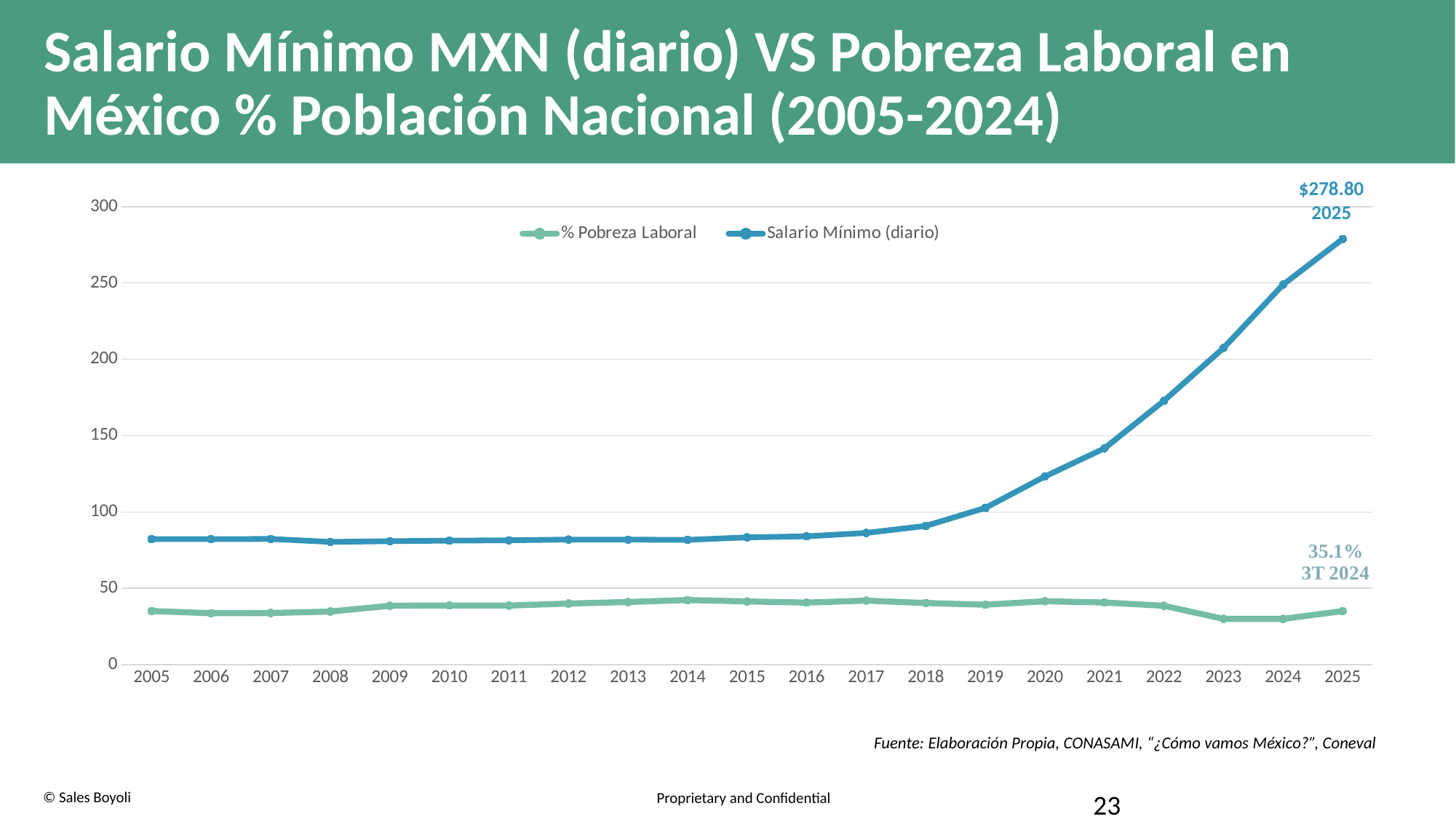
What is the value of Salario Mínimo (diario) for 2025? $278.80 Is the value of Salario Mínimo (diario) for 2021 greater or less than 150? less Is the value of Salario Mínimo (diario) for 2018 greater or less than 100? less What value is labelled for % Pobreza Laboral at 3T 2024? 35.1% Which is larger, Salario Mínimo (diario) in 2024 or in 2020? 2024 How many series does the legend list? 2 What kind of chart is shown on the slide? Line chart In which year is Salario Mínimo (diario) highest? 2025 Does Salario Mínimo (diario) rise or fall from 2018 to 2025? Rises How many years are shown on the x axis? 21 Is the value of Salario Mínimo (diario) for 2022 greater or less than 150? greater What colour is the Salario Mínimo (diario) line? Blue